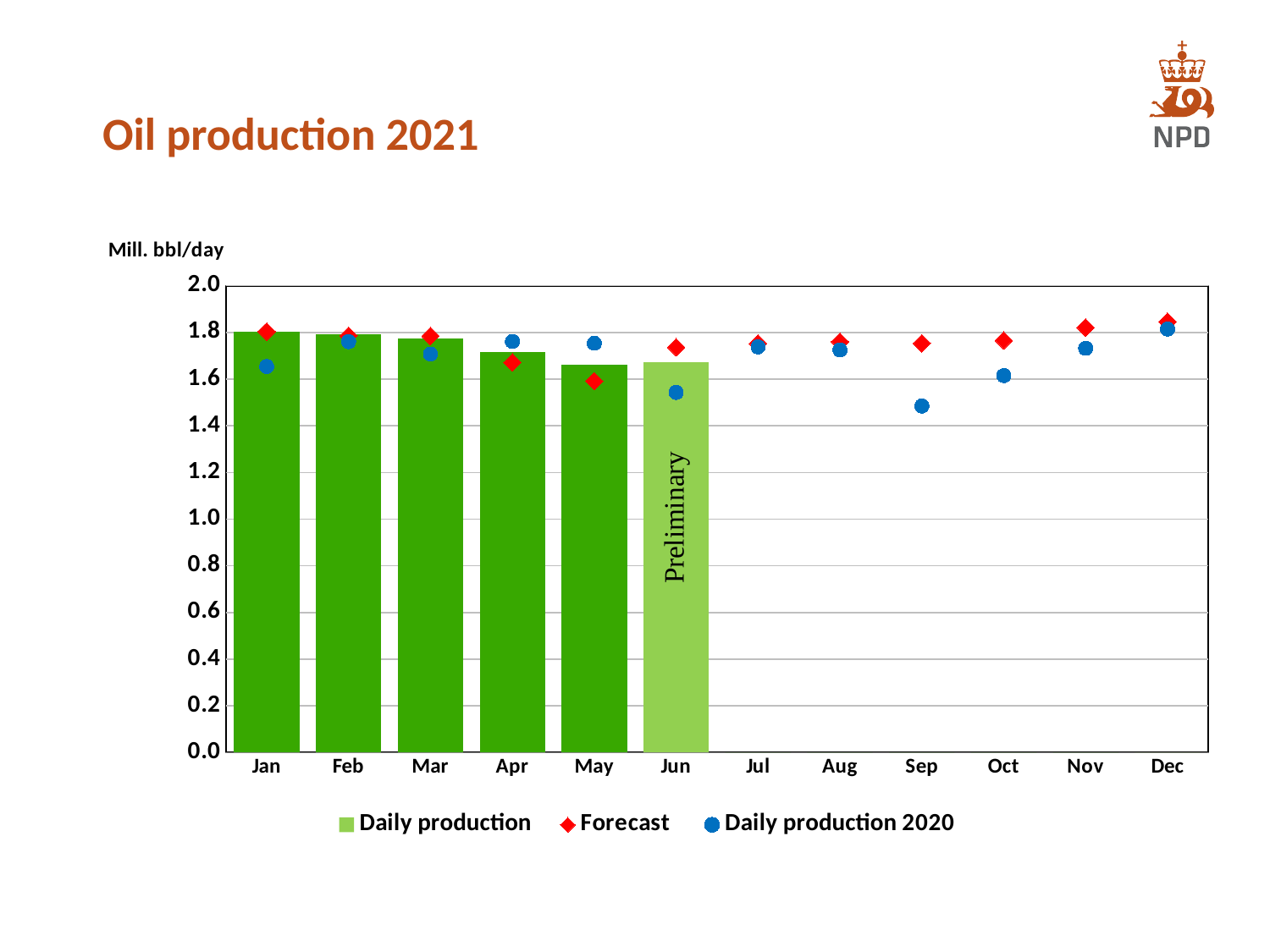
Is the Daily production 2020 value for Sep greater or less than 1.6? less Which is larger, the Daily production 2020 value for Sep or for Dec? Dec What kind of chart is shown on the slide? combination bar and line chart How many months have a Daily production bar plotted? 6 How many months are shown along the x axis? 12 Is the Forecast value for Dec greater or less than 1.8? greater Which month has the lowest Daily production 2020 value? Sep How many series does the legend list? 3 Do the Daily production bars rise or fall from Jan to May? fall Is the Daily production bar for May greater or less than 1.8? less What label is written on the Jun bar? Preliminary